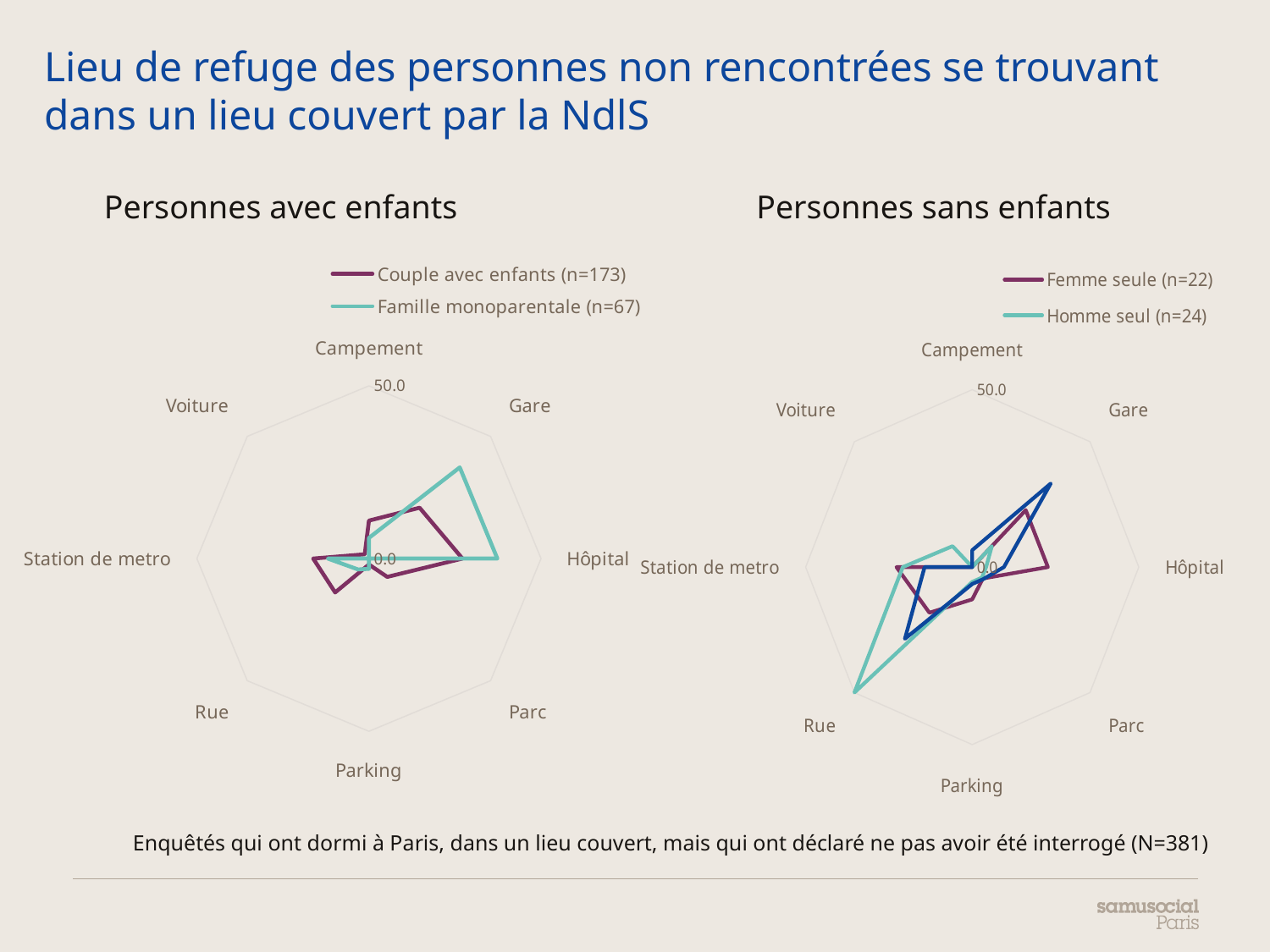
In the "Personnes avec enfants" chart, which category has the highest value for Famille monoparentale (n=67)? Gare and Hôpital (tied) How many series does the legend of the "Personnes sans enfants" chart list? 2 What kind of chart is the "Personnes avec enfants" chart? Radar chart In the "Personnes avec enfants" chart, is the value for Hôpital for Couple avec enfants (n=173) greater or less than 50? less What are the two legend entries of the "Personnes sans enfants" chart? Femme seule (n=22) and Homme seul (n=24) In the "Personnes sans enfants" chart, which series has the larger value for Rue: Femme seule (n=22) or Homme seul (n=24)? Homme seul (n=24) In the "Personnes avec enfants" chart, which series has the larger value for Gare: Couple avec enfants (n=173) or Famille monoparentale (n=67)? Famille monoparentale (n=67) In the "Personnes sans enfants" chart, is the value for Gare for Homme seul (n=24) greater or less than 50? less How many categories are plotted on the "Personnes sans enfants" chart? 8 In the "Personnes avec enfants" chart, which category has the highest value for Couple avec enfants (n=173)? Hôpital In the "Personnes sans enfants" chart, which category has the highest value for Homme seul (n=24)? Rue How many series does the legend of the "Personnes avec enfants" chart list? 2